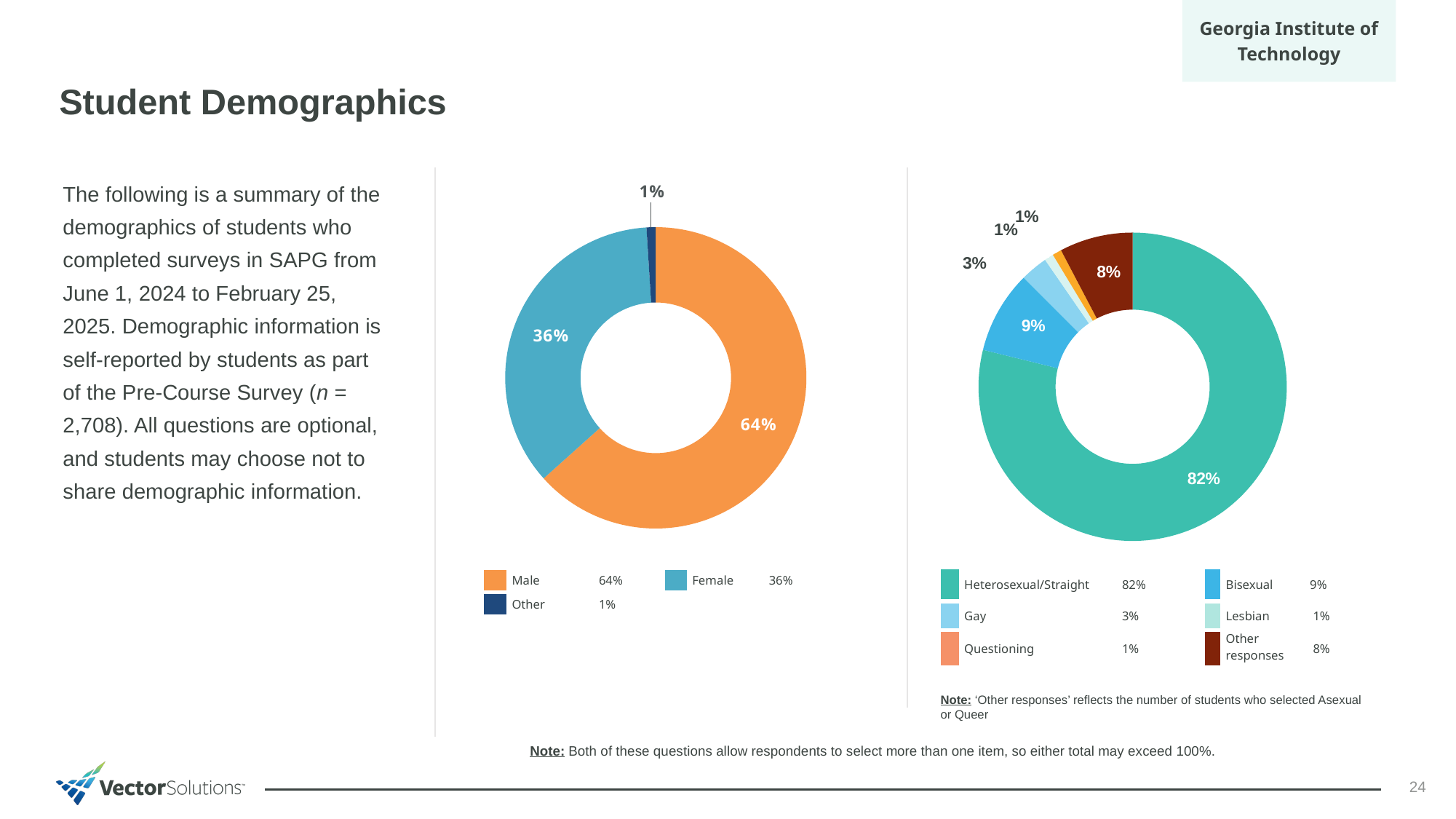
In the right donut chart (sexual orientation), what percentage is shown for Bisexual? 9% In the left donut chart (gender), how many categories does the legend list? 3 In the left donut chart (gender), what percentage is shown for Male? 64% In the right donut chart (sexual orientation), what percentage is shown for Other responses? 8% In the right donut chart (sexual orientation), which category has the largest share? Heterosexual/Straight What type of chart is used on this slide? Donut (pie) chart In the right donut chart (sexual orientation), how many categories does the legend list? 6 In the right donut chart (sexual orientation), which is larger, Gay or Bisexual? Bisexual In the right donut chart (sexual orientation), what percentage is shown for Heterosexual/Straight? 82% In the left donut chart (gender), what is the difference between the Male and Female percentages? 28% In the left donut chart (gender), what percentage is shown for Female? 36% In the left donut chart (gender), which category has the smallest share? Other